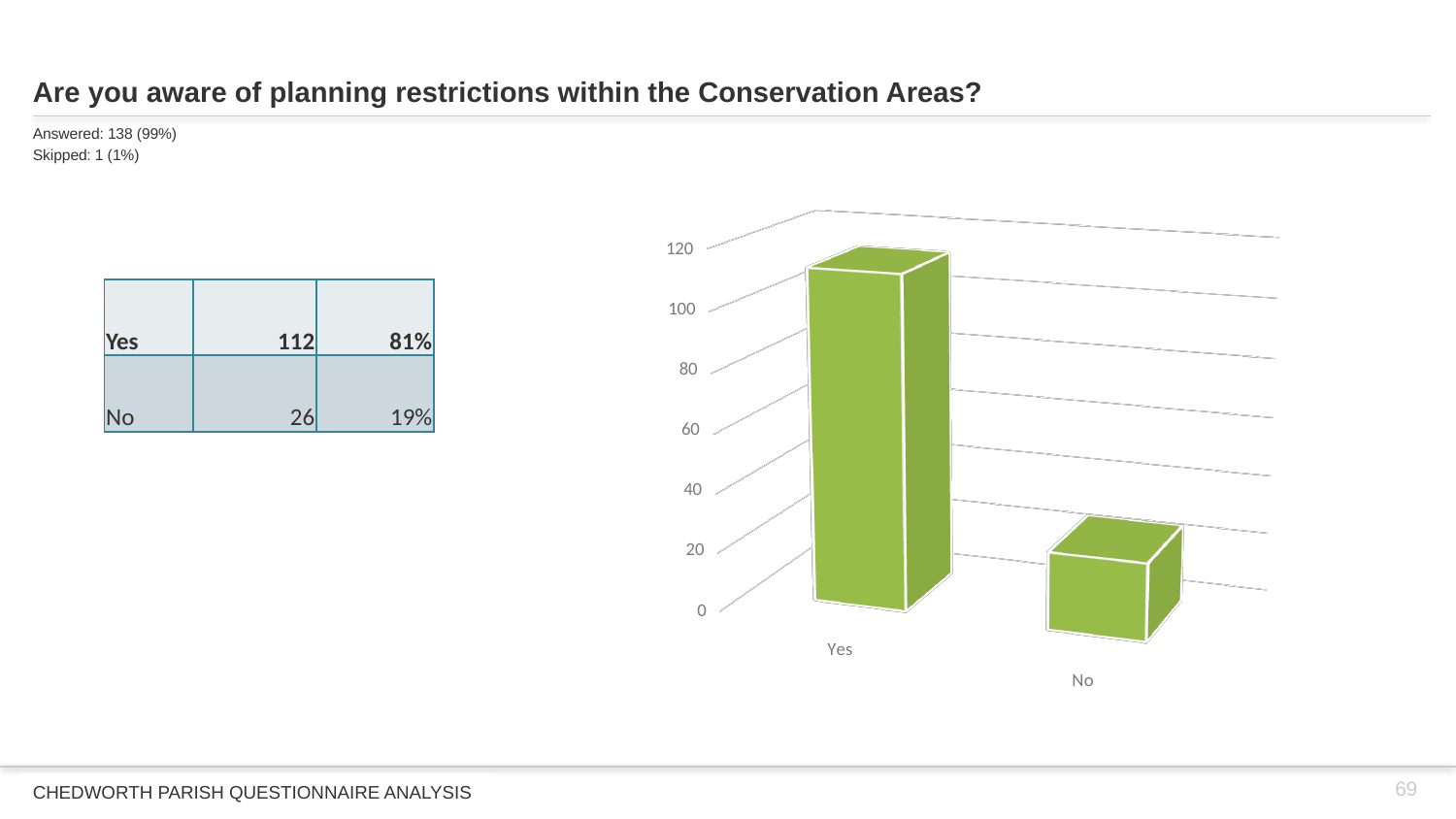
According to the slide, how many respondents answered Yes? 112 What is the difference between the number of Yes and No responses? 86 Is the value for Yes greater or less than 100? greater Which category has the lowest value in the chart? No Which is larger, the value for Yes or the value for No? Yes What percentage of respondents answered Yes? 81% According to the slide, how many respondents answered No? 26 What kind of chart is shown on the slide? Bar chart What is the highest value shown on the vertical axis of the chart? 120 Which category has the highest value in the chart? Yes How many categories are plotted in the chart? 2 Is the value for No greater or less than 40? less